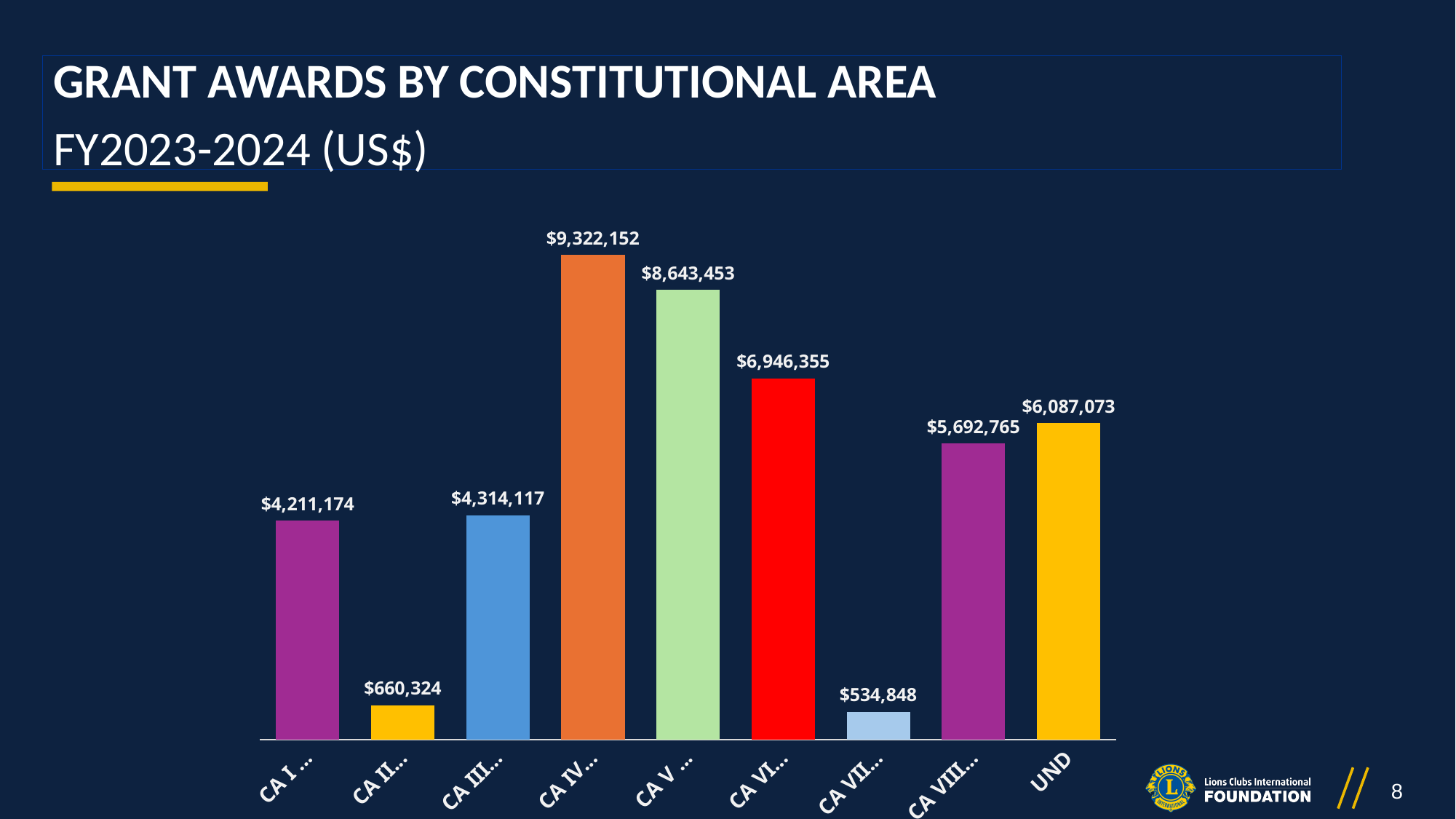
What is the grant award value for CA VII? $534,848 What is the grant award value for CA VIII? $5,692,765 How many categories are shown on the chart? 9 What is the difference between the grant awards for UND and CA VIII? $394,308 What kind of chart is shown on the slide? Bar chart Which constitutional area has the highest grant award value? CA IV What is the grant award value for UND? $6,087,073 What is the grant award value for CA IV? $9,322,152 What is the difference between the grant awards for CA IV and CA V? $678,699 Which category has the lowest grant award value? CA VII Which has a larger grant award value, CA VI or CA V? CA V Which has a larger grant award value, CA II or CA VII? CA II